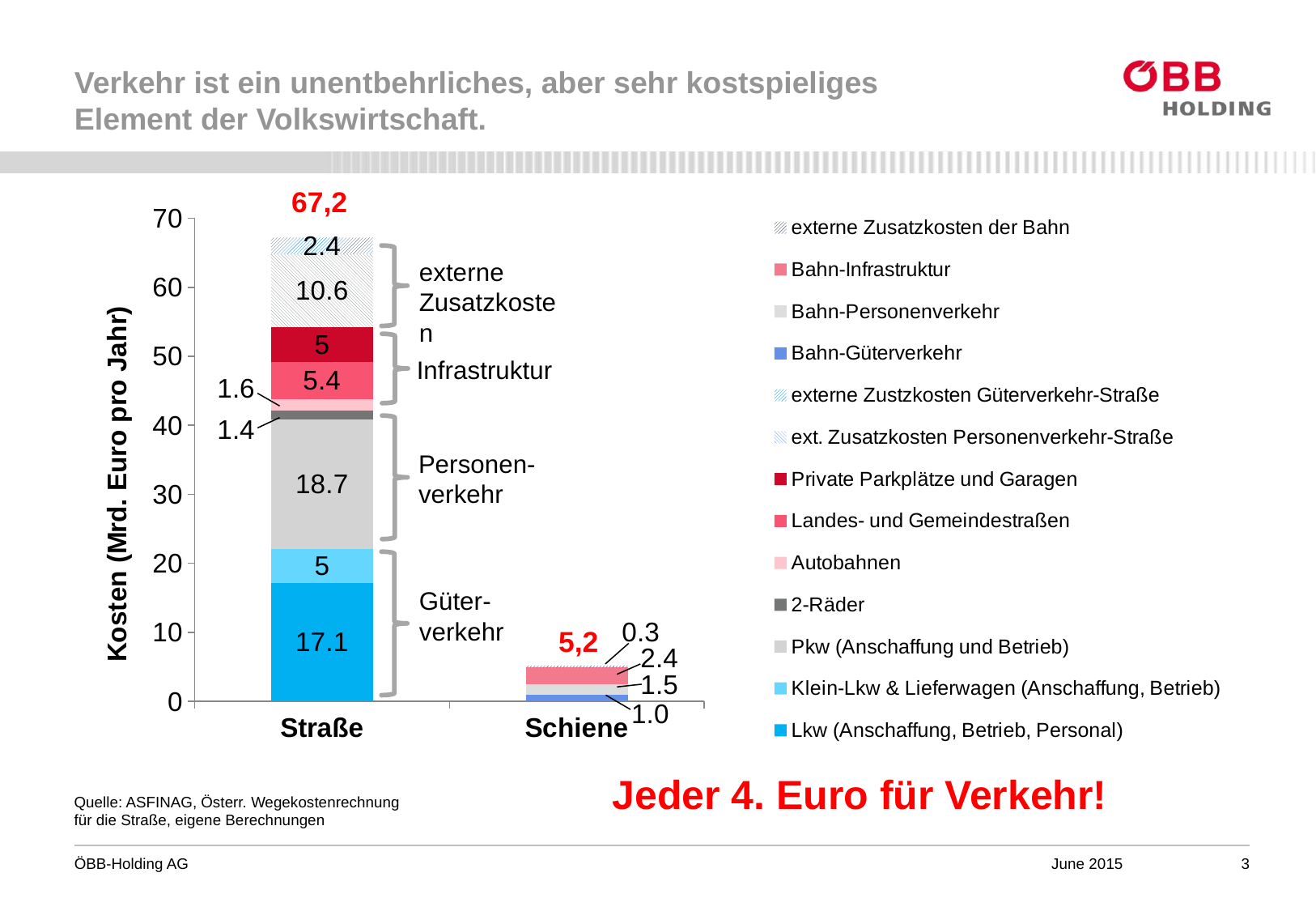
Which category has the higher total, Straße or Schiene? Straße What is the total value shown for the Straße bar? 67,2 Is the total for the Straße bar greater or less than 60? greater What is the value for Bahn-Infrastruktur in the Schiene bar? 2.4 What is the value for Lkw (Anschaffung, Betrieb, Personal) in the Straße bar? 17.1 What is the total value shown for the Schiene bar? 5,2 How many categories are shown on the x axis? 2 How many series does the legend list? 13 What is the label of the y axis? Kosten (Mrd. Euro pro Jahr) What is the value for Pkw (Anschaffung und Betrieb) in the Straße bar? 18.7 What kind of chart is shown on the slide? stacked bar chart What is the difference between the Pkw (Anschaffung und Betrieb) value and the Lkw (Anschaffung, Betrieb, Personal) value in the Straße bar? 1.6